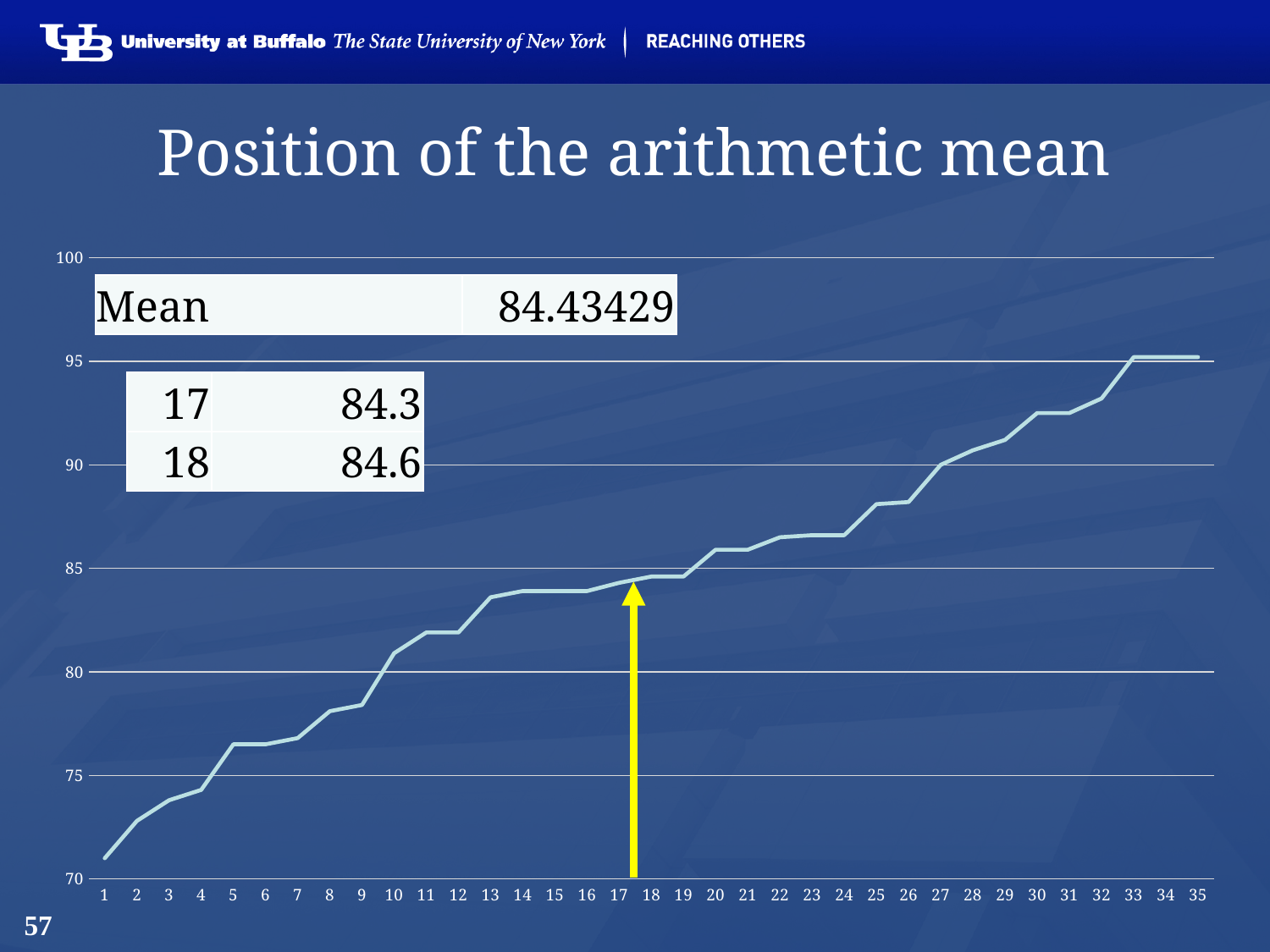
What is the difference between the values for positions 18 and 17 shown in the table? 0.3 What kind of chart is shown on the slide? line chart What is the value of the mean shown in the table on the chart? 84.43429 What is the title of the chart on the slide? Position of the arithmetic mean What is the value for position 18 according to the table on the chart? 84.6 What is the value for position 17 according to the table on the chart? 84.3 How many data points are plotted along the x axis? 35 Which x-axis position has the lowest plotted value? 1 Is the value for position 30 greater or less than 90? greater Do the plotted values rise or fall as the x axis goes from 1 to 35? rise Is the value for position 1 greater or less than 75? less Is the value for position 25 greater or less than 85? greater